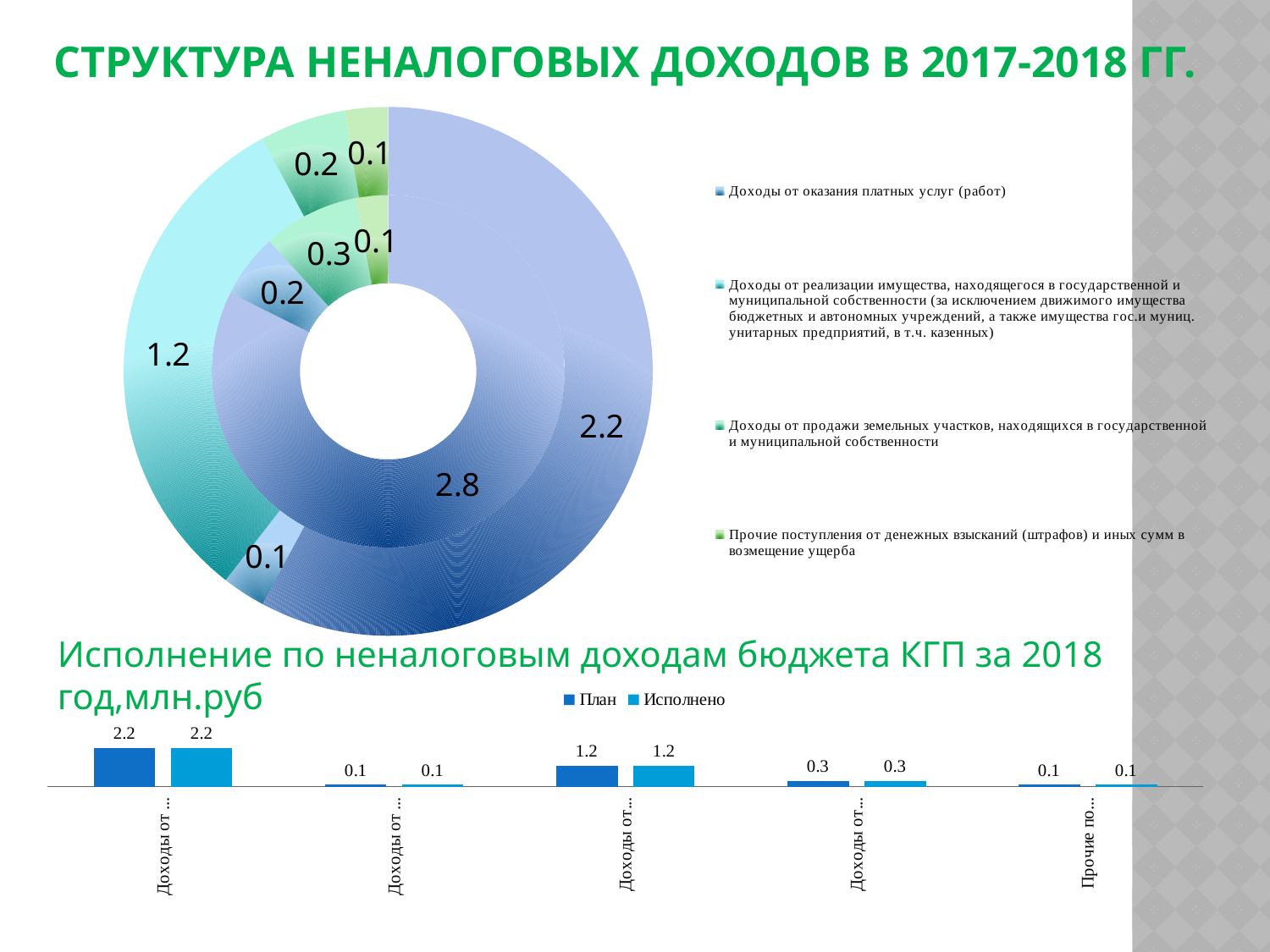
What kind of chart is the bottom chart titled 'Исполнение по неналоговым доходам бюджета КГП за 2018 год,млн.руб'? bar chart What kind of chart is the top chart on the slide? doughnut chart In the bottom bar chart, what is the difference between the План and Исполнено values for the third category? 0 In the top doughnut chart, what is the largest value labelled on the inner ring? 2.8 In the bottom bar chart, which is larger: the План value for the first category or the План value for the third category? the first category (2.2) In the bottom bar chart, which category has the highest План value? the first (leftmost) category, 2.2 In the bottom bar chart, what are the two series named in the legend? План and Исполнено In the bottom bar chart, what is the Исполнено value for the third category? 1.2 In the bottom bar chart, how many series does the legend list? 2 In the bottom bar chart, how many categories are shown along the x axis? 5 In the bottom bar chart, what is the План value for the first (leftmost) category? 2.2 In the bottom bar chart, what is the Исполнено value for the fourth category? 0.3